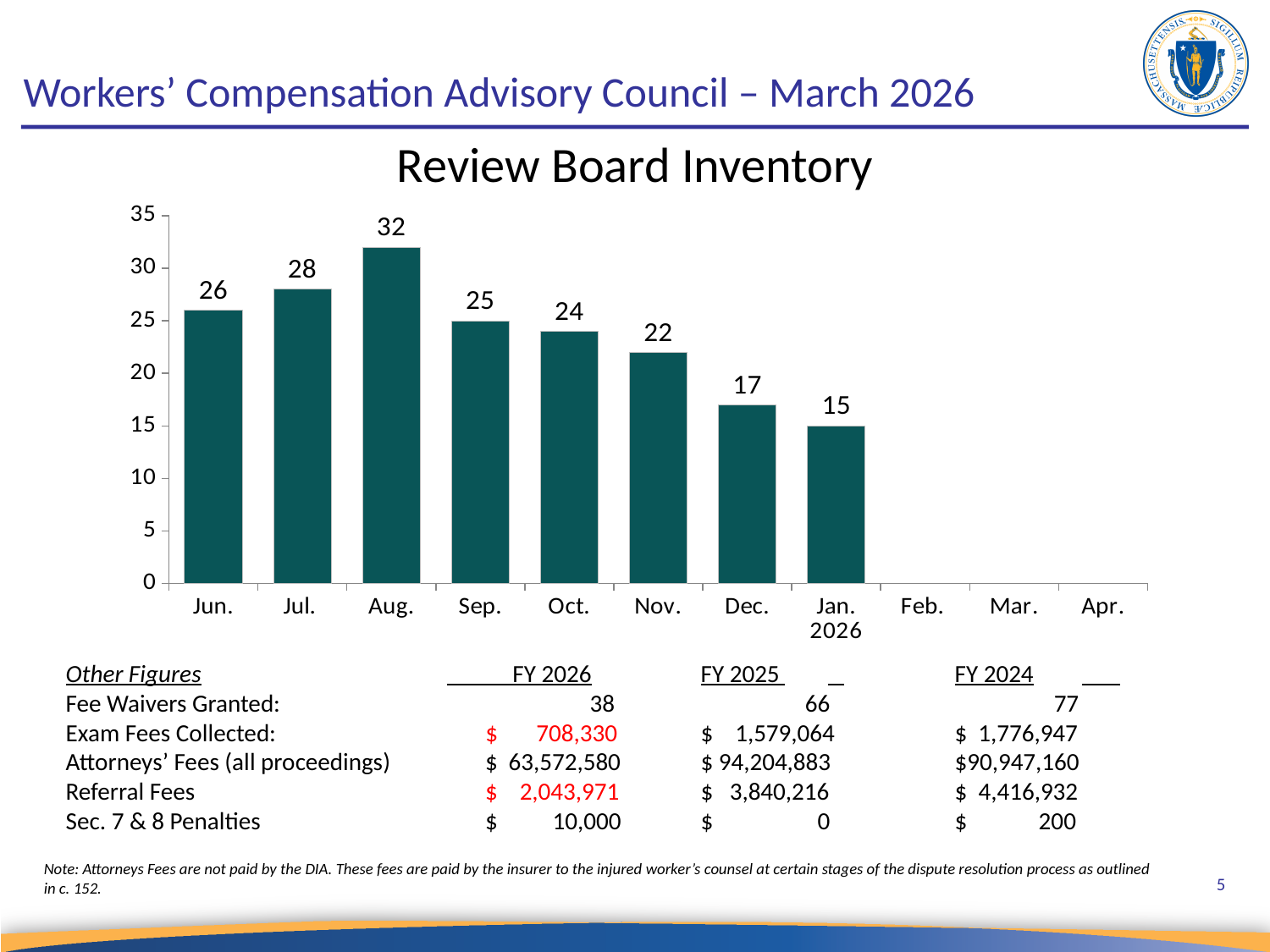
What is the Review Board Inventory value for Nov.? 22 What kind of chart is the Review Board Inventory chart? bar chart What is the Review Board Inventory value for Jan. 2026? 15 What is the Review Board Inventory value for Aug.? 32 What is the difference between the Review Board Inventory for Aug. and Jan. 2026? 17 Which month with a plotted bar has the lowest Review Board Inventory? Jan. 2026 Which month has the highest Review Board Inventory? Aug. What is the difference between the Review Board Inventory for Jul. and Jun.? 2 Is the Review Board Inventory value for Oct. greater or less than 20? greater Which is larger, the Review Board Inventory for Sep. or for Dec.? Sep. How many months have a plotted bar in the Review Board Inventory chart? 8 From Aug. to Jan. 2026, does the Review Board Inventory rise or fall? fall